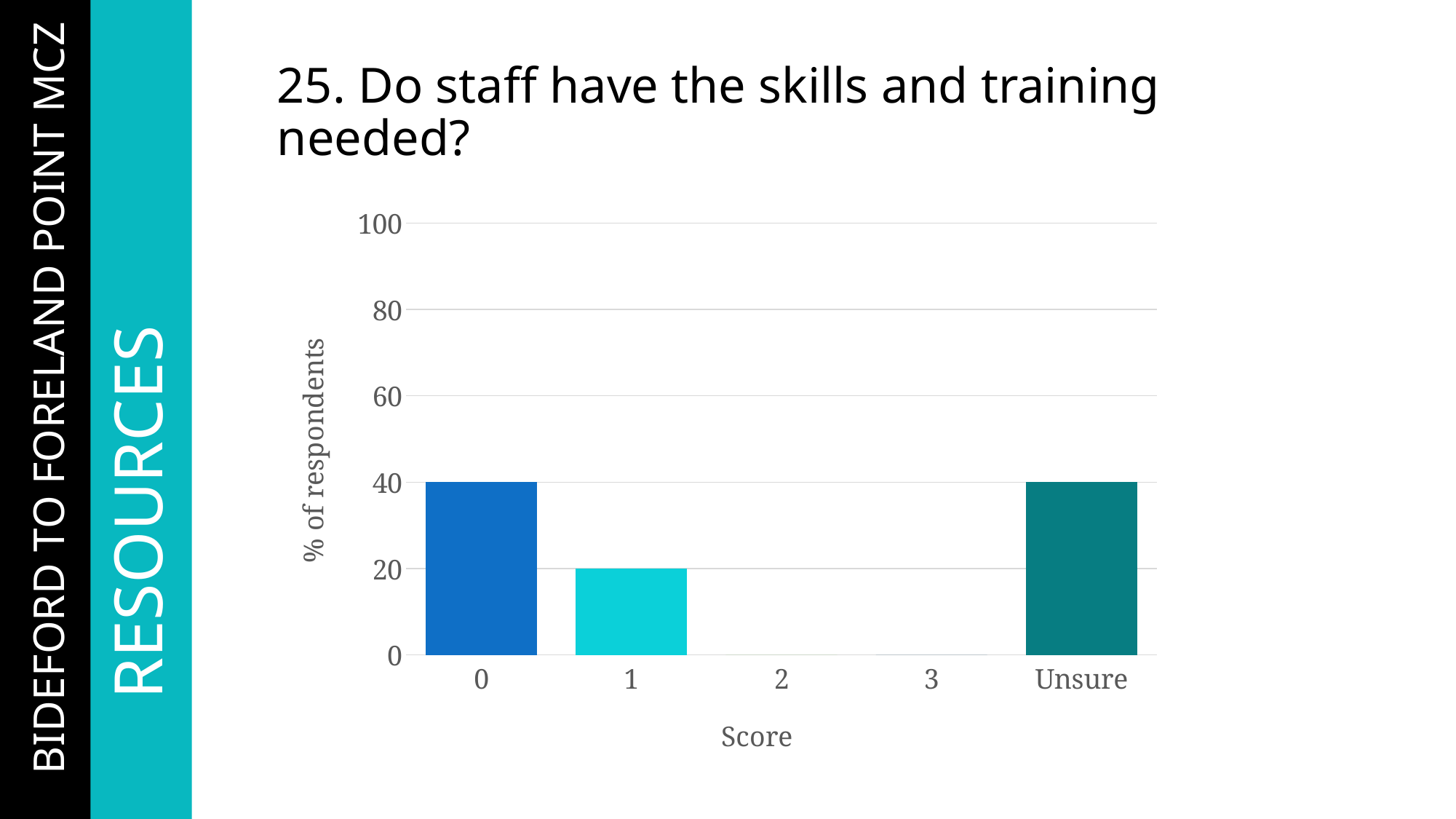
What is the value for score 2? 0 What is the value for Unsure? 40 Which is larger, the value for score 0 or the value for score 1? score 0 What is the value for score 3? 0 What is the value for score 0? 40 Which is larger, the value for Unsure or the value for score 1? Unsure What is the label of the y axis? % of respondents What is the value for score 1? 20 What is the difference between the value for score 0 and the value for score 1? 20 What is the label of the x axis? Score What kind of chart is shown on the slide? bar chart How many categories are shown on the x axis? 5